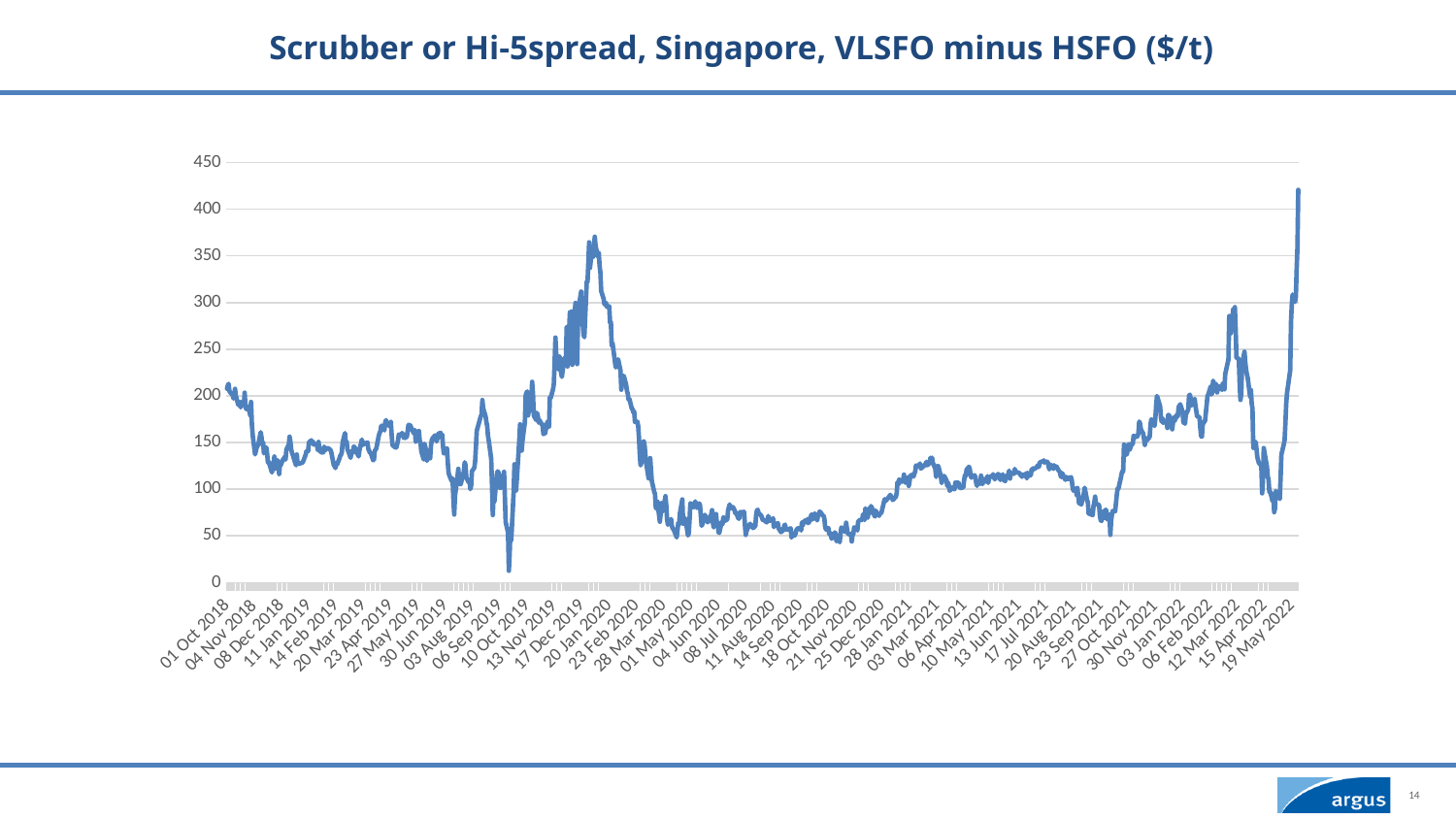
Around which date label does the line reach its highest value? 19 May 2022 Is the value at 19 May 2022 greater or less than 400? less Between 30 Nov 2021 and 12 Mar 2022, does the line generally rise or fall? rise Is the value at 14 Sep 2020 greater or less than 100? less Is the value at 01 Oct 2018 greater or less than 150? greater What is the highest value shown on the vertical axis of the chart? 450 Between 20 Jan 2020 and 01 May 2020, does the line generally rise or fall? fall What kind of chart is shown on the slide? line chart What is the title of the chart? Scrubber or Hi-5spread, Singapore, VLSFO minus HSFO ($/t)